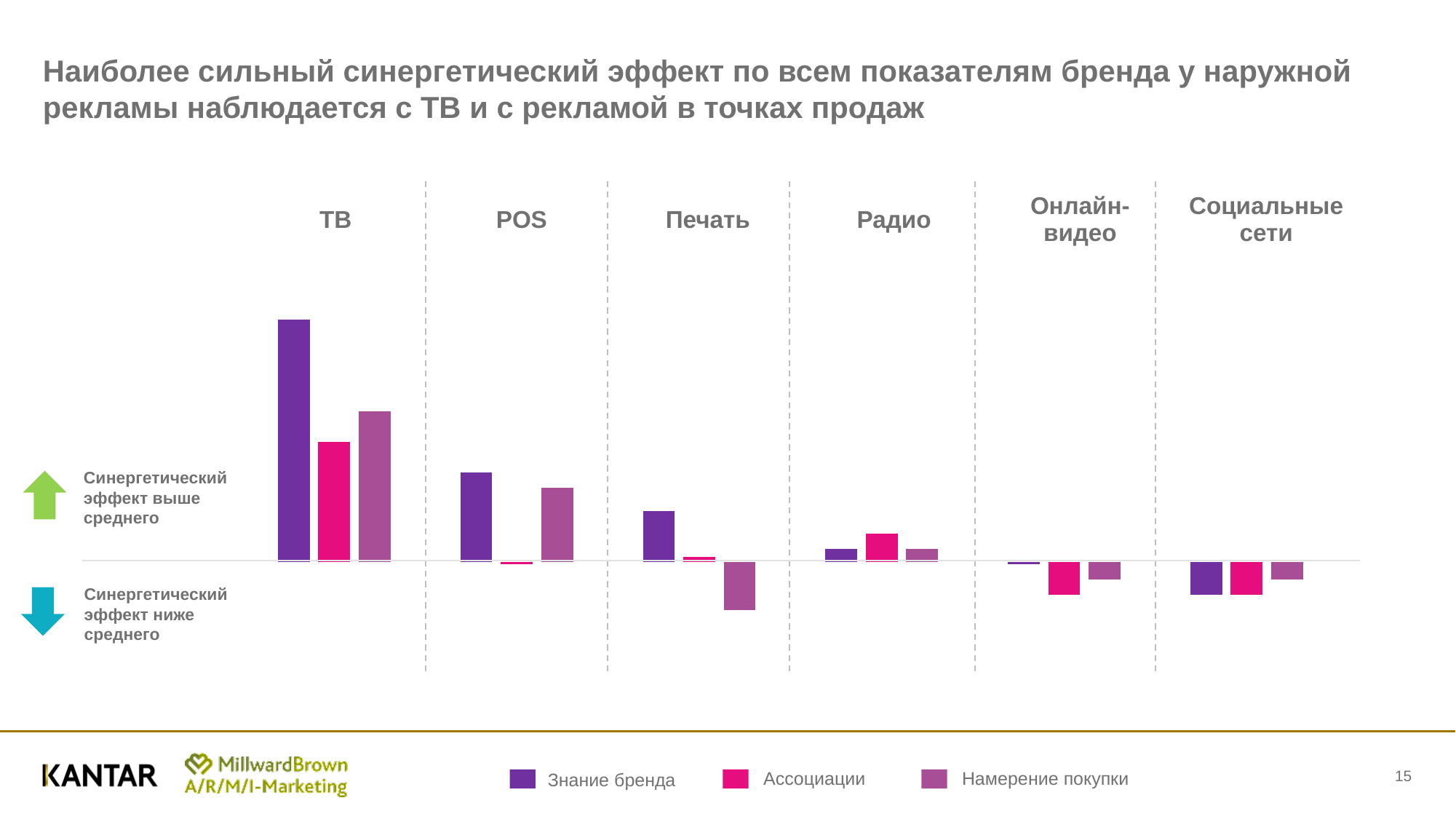
In the Радио category, which is larger: Ассоциации or Знание бренда? Ассоциации Which is larger: Знание бренда for ТВ or Знание бренда for POS? Знание бренда for ТВ What kind of chart is shown on the slide? bar chart In the Печать category, which is larger: Знание бренда or Намерение покупки? Знание бренда Which media category has the highest bar for Знание бренда? ТВ Do the Знание бренда values generally rise or fall moving from ТВ to Социальные сети? fall Which series is shown in pink in the legend? Ассоциации Which bar on the chart is the lowest (most negative)? Намерение покупки for Печать How many series does the chart legend list? 3 How many media categories are shown along the x axis of the chart? 6 Within the ТВ category, which series has the tallest bar? Знание бренда